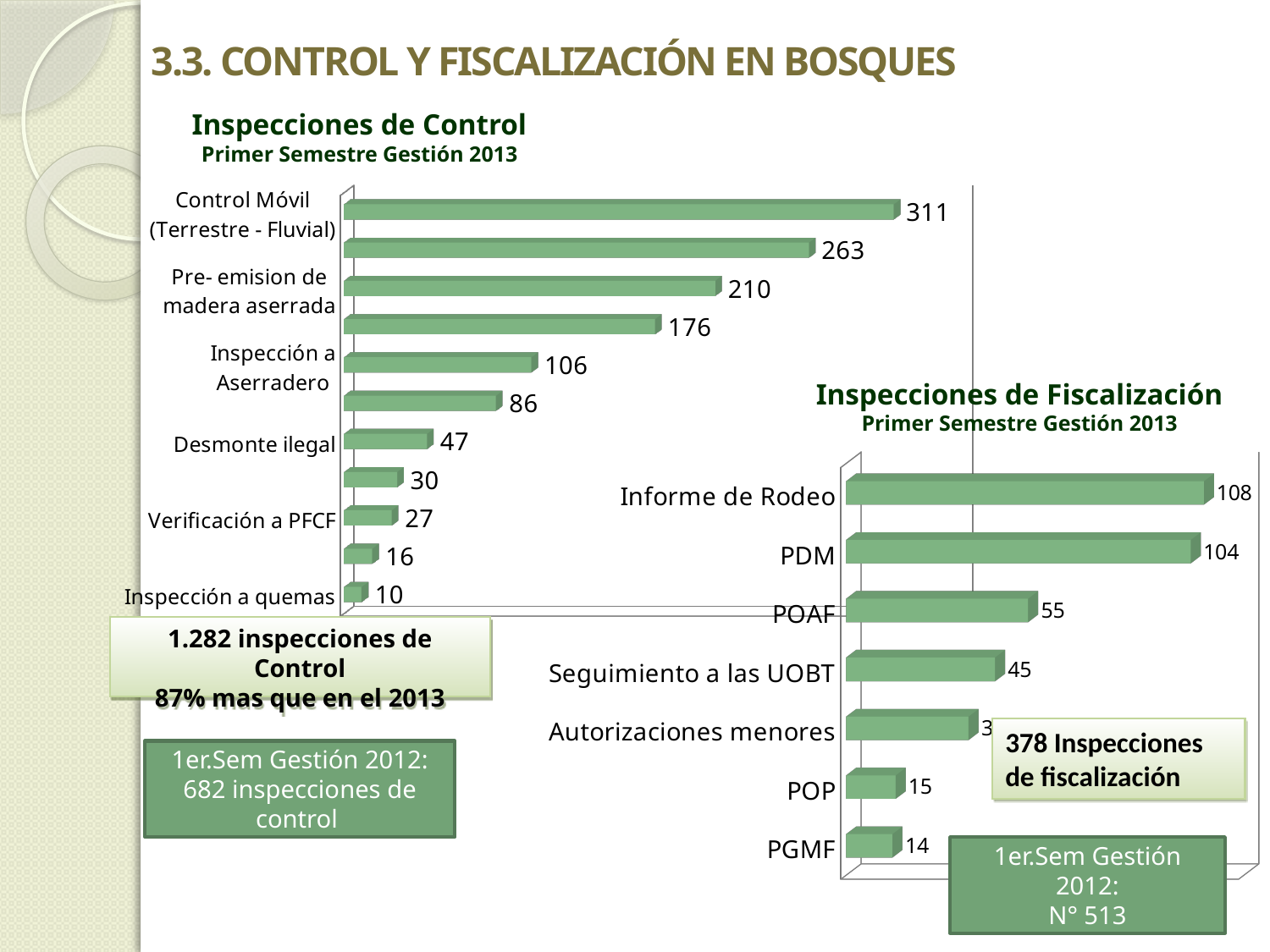
In the Inspecciones de Control chart, what is the value for Inspección a quemas? 10 In the Inspecciones de Control chart, what is the value for Pre- emision de madera aserrada? 210 What kind of chart is the Inspecciones de Control chart? Bar chart In the Inspecciones de Control chart, which category has the highest value? Control Móvil (Terrestre - Fluvial) How many bars are plotted in the Inspecciones de Fiscalización chart? 7 In the Inspecciones de Fiscalización chart, which category has the lowest value? PGMF In the Inspecciones de Fiscalización chart, what is the value for PDM? 104 In the Inspecciones de Fiscalización chart, what is the difference between Informe de Rodeo and POAF? 53 In the Inspecciones de Control chart, what is the value for Control Móvil (Terrestre - Fluvial)? 311 In the Inspecciones de Fiscalización chart, which is larger, POP or PGMF? POP In the Inspecciones de Control chart, what is the difference between Inspección a Aserradero and Desmonte ilegal? 59 In the Inspecciones de Fiscalización chart, what is the value for Seguimiento a las UOBT? 45